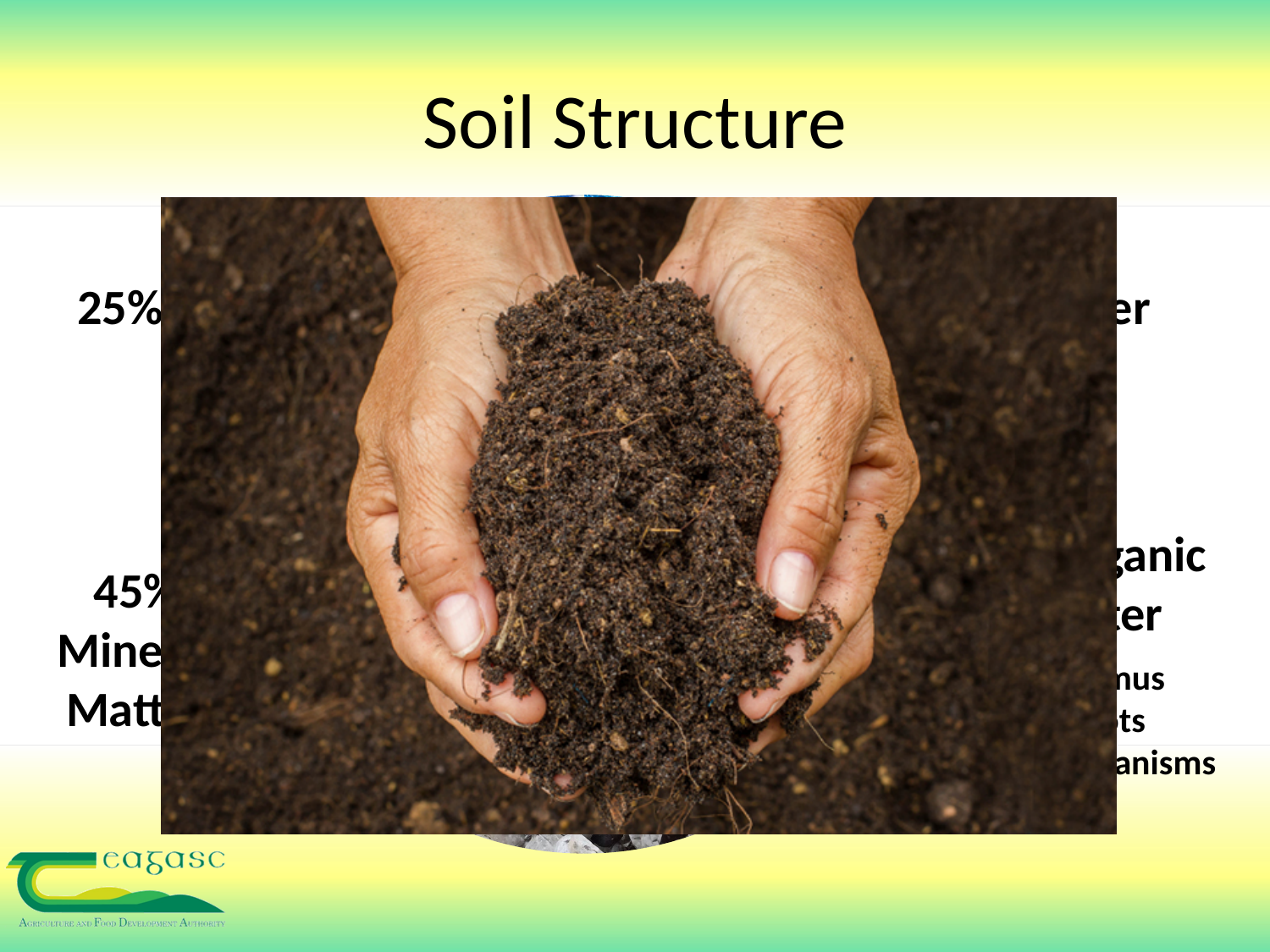
What kind of chart is partially visible behind the photo on the slide? pie chart What percentage of the soil is shown as Mineral Matter on the Soil Structure chart? 45% What is the title of the slide containing the chart? Soil Structure